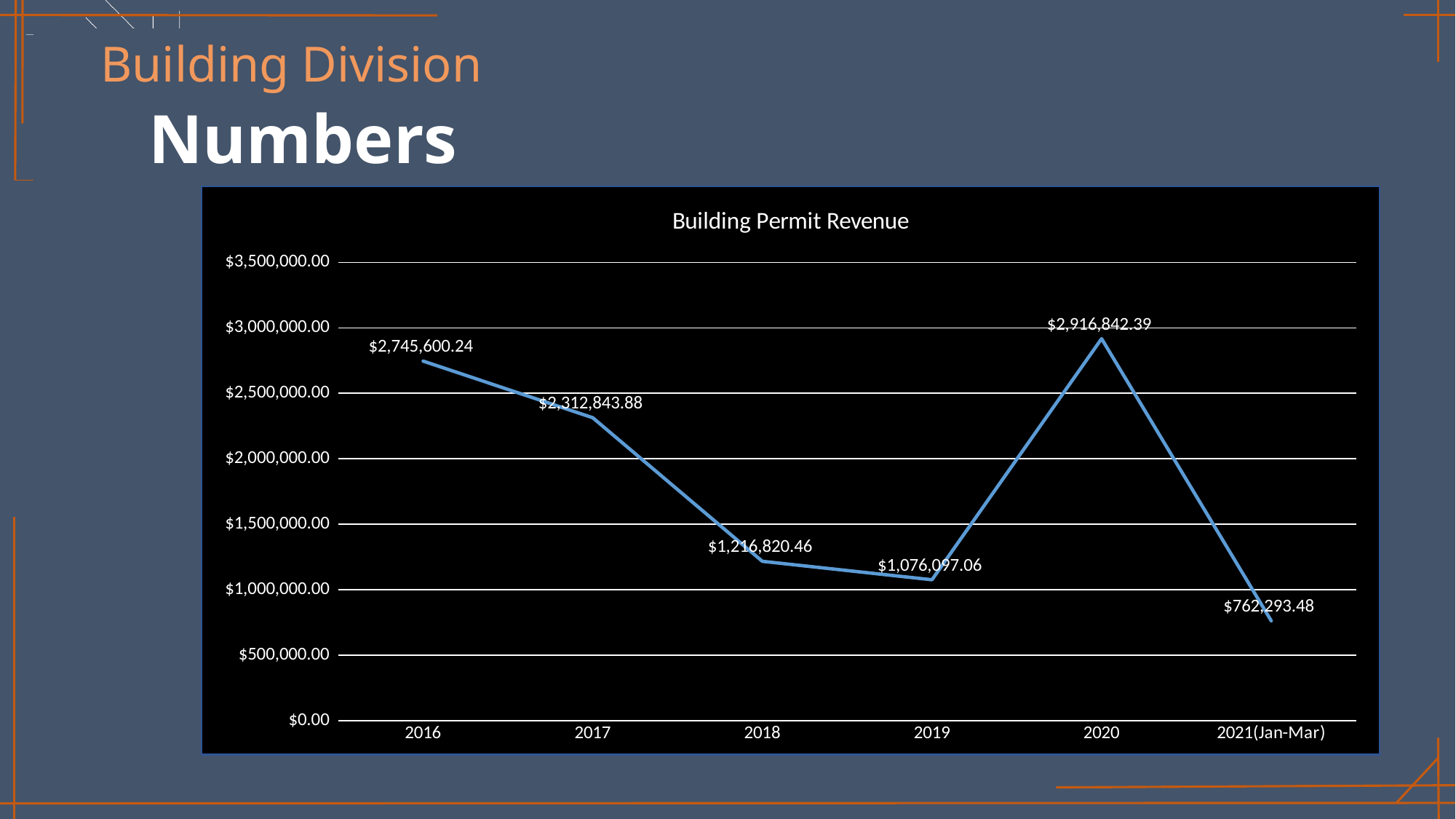
What is the Building Permit Revenue for 2020? $2,916,842.39 Which year has higher Building Permit Revenue, 2017 or 2018? 2017 What kind of chart is the Building Permit Revenue chart? line chart What is the Building Permit Revenue for 2021(Jan-Mar)? $762,293.48 What is the Building Permit Revenue for 2019? $1,076,097.06 Does the Building Permit Revenue rise or fall from 2016 to 2019? fall What is the difference in Building Permit Revenue between 2018 and 2019? $140,723.40 Which category has the lowest Building Permit Revenue? 2021(Jan-Mar) How many categories are shown on the x axis of the Building Permit Revenue chart? 6 What is the Building Permit Revenue for 2016? $2,745,600.24 What is the difference in Building Permit Revenue between 2016 and 2017? $432,756.36 Which year has the highest Building Permit Revenue? 2020